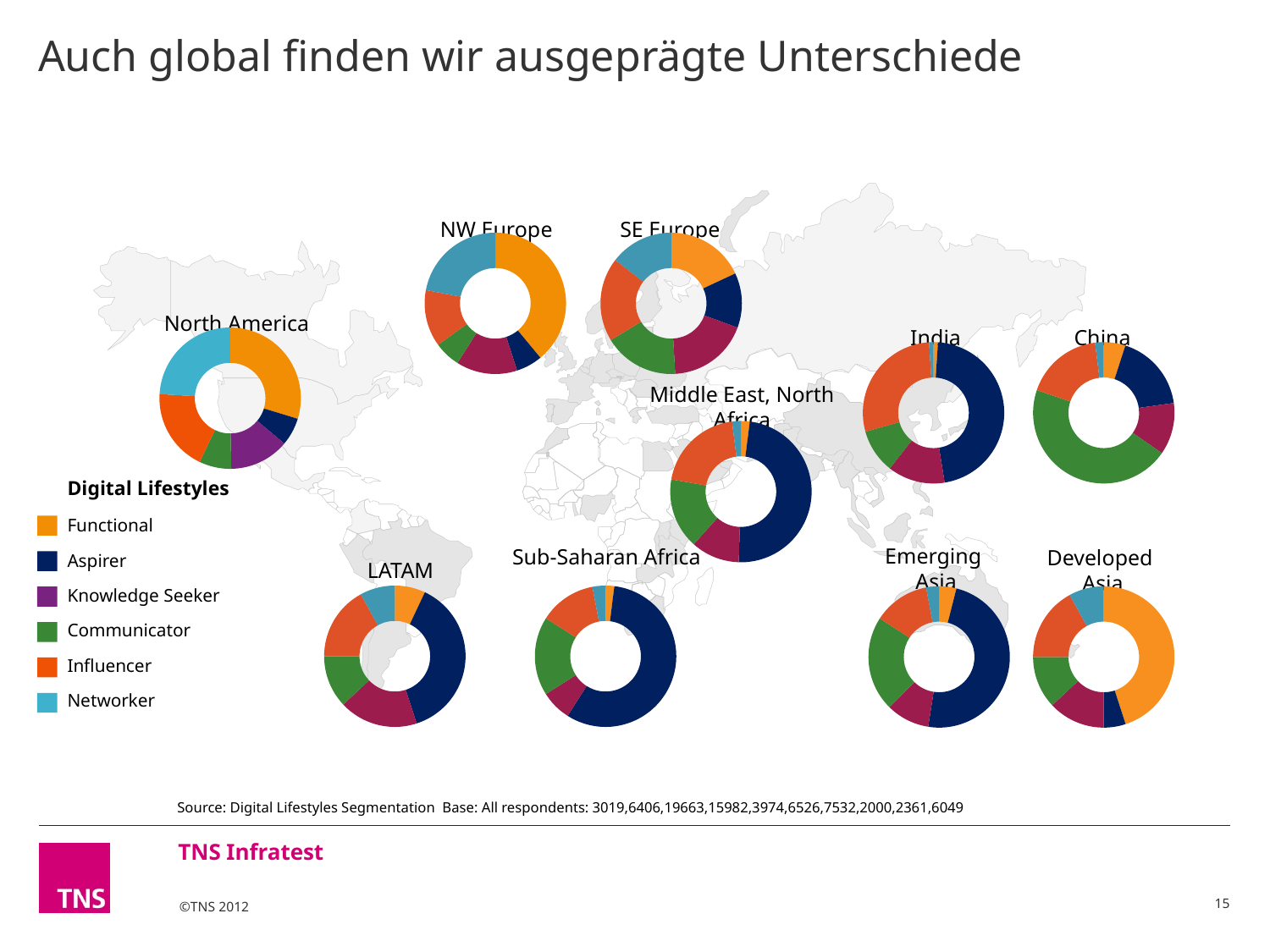
In the China chart, which is larger: the Communicator segment or the Aspirer segment? Communicator In the India chart, which segment is the largest? Aspirer Which colour represents the Aspirer segment in the legend? Dark blue How many regional donut charts are shown on the slide? 10 In the Developed Asia chart, which segment is the largest? Functional What kind of chart is used for each region on the slide? Pie (donut) chart In the Middle East, North Africa chart, which segment is the largest? Aspirer How many segments does the Digital Lifestyles legend list? 6